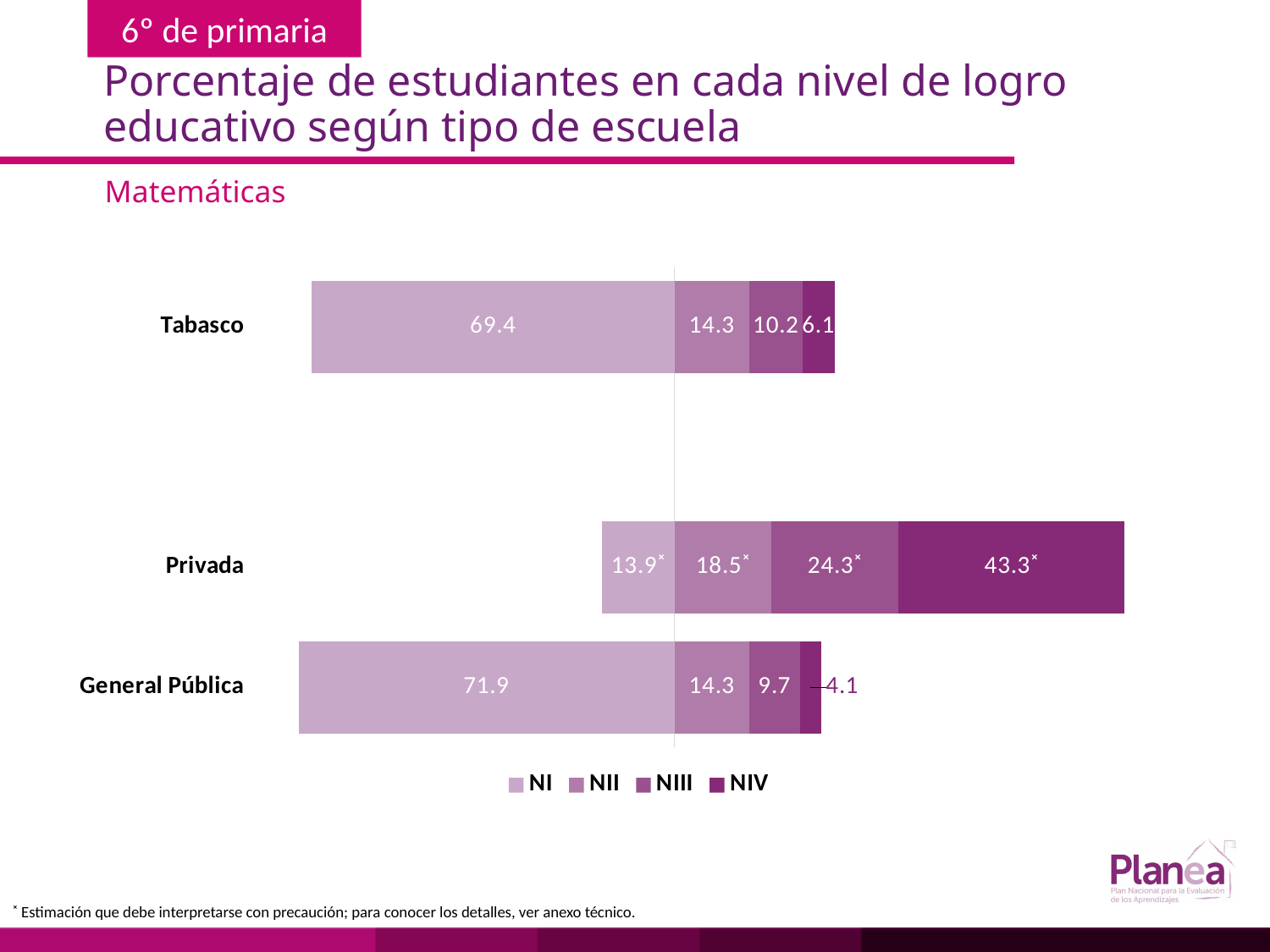
How many categories (school types) are shown in the chart? 3 What is the NIV value for Privada? 43.3* What is the total of the stacked bar for Tabasco? 100.0 Which is larger, the NIV value for Tabasco or the NIV value for General Pública? Tabasco What is the NIII value for General Pública? 9.7 What is the NII value for Tabasco? 14.3 Which school type has the lowest NIV value? General Pública How many series does the legend list? 4 Which school type has the highest NI value? General Pública What type of chart is shown on the slide? stacked bar chart What is the NI value for Tabasco? 69.4 What is the difference between the NI values for General Pública and Tabasco? 2.5